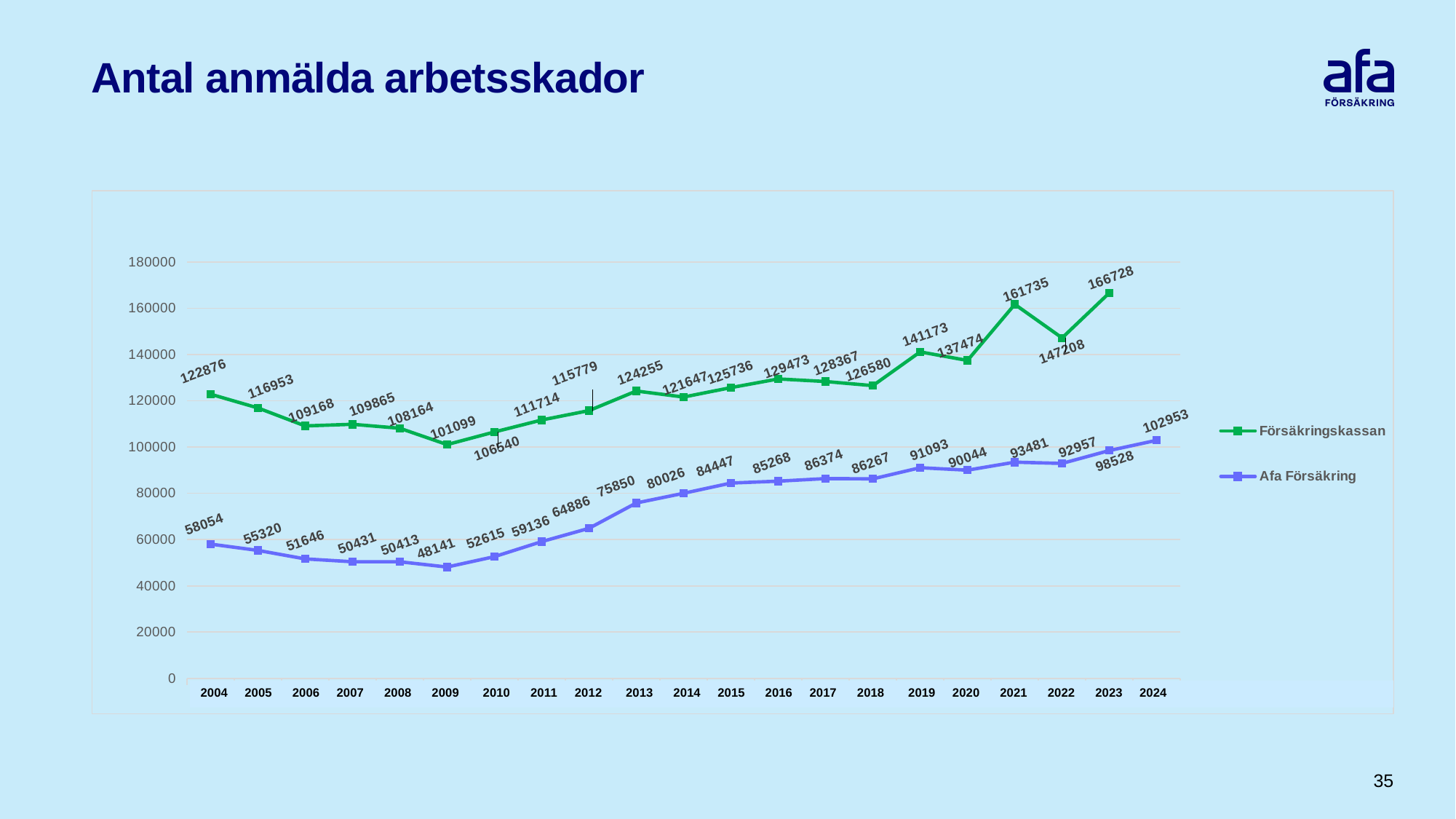
How many years are shown on the x axis? 21 For Försäkringskassan, which year has the larger value, 2021 or 2022? 2021 What kind of chart is shown on the slide? Line chart What is the value for Försäkringskassan in 2009? 101099 What is the value for Afa Försäkring in 2013? 75850 What is the value for Afa Försäkring in 2024? 102953 What is the difference between the Försäkringskassan values for 2023 and 2022? 19520 Does the Afa Försäkring series rise or fall from 2009 to 2024? Rise In which year does the Afa Försäkring series reach its lowest value? 2009 How much higher is the Afa Försäkring value in 2024 than in 2004? 44899 In which year does the Försäkringskassan series reach its highest value? 2023 How many series does the legend list? 2